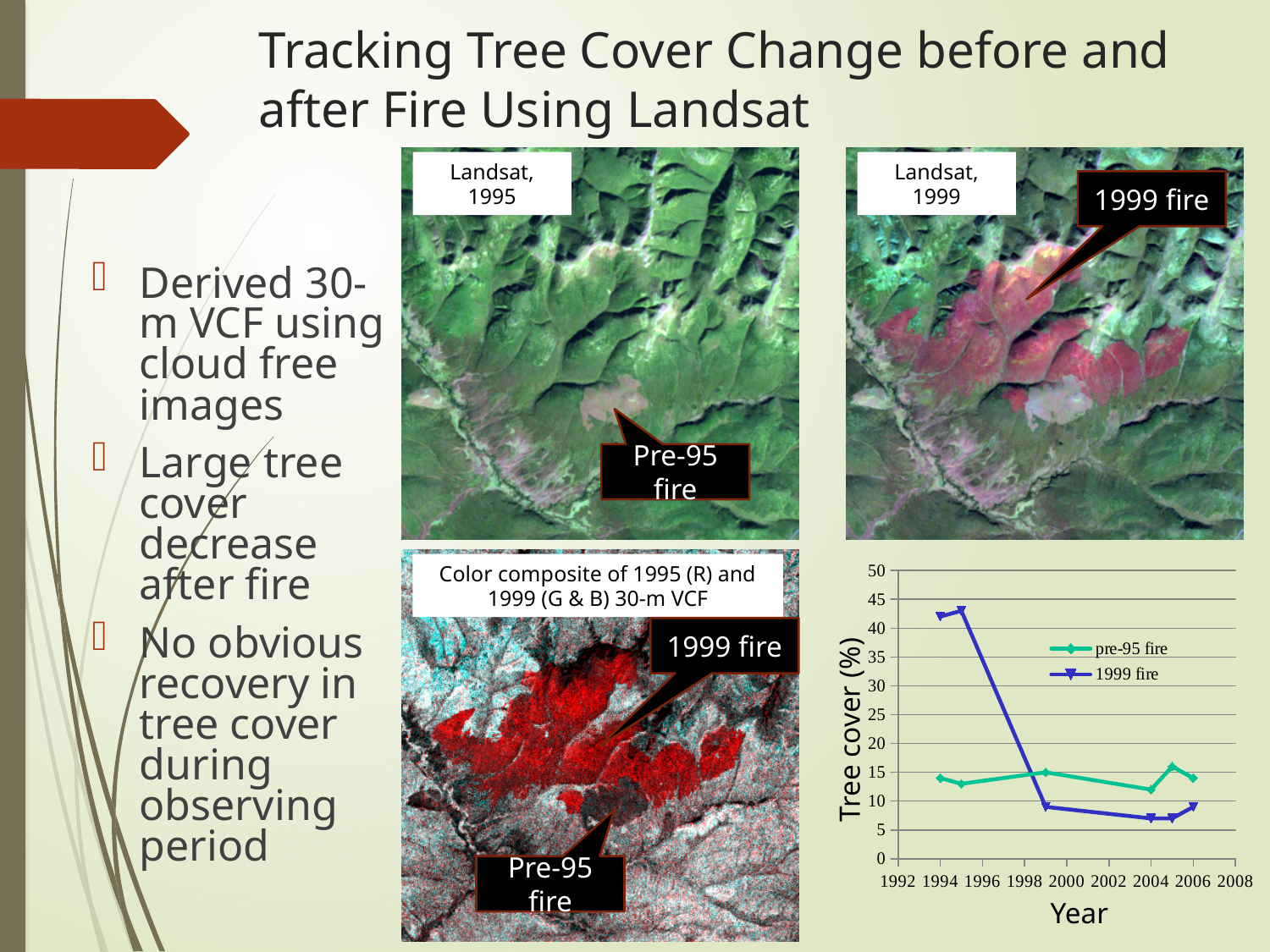
In the tree cover chart, is the value for the 1999 fire series in 2004 greater or less than 10? less How many series does the legend of the tree cover chart list? 2 In the tree cover chart, is the value for the pre-95 fire series in 1999 greater or less than 20? less In the tree cover chart, which series shows the larger drop in tree cover over the observing period? 1999 fire In the tree cover chart, does the 1999 fire series rise or fall between 1995 and 1999? fall In the tree cover chart, which series has the higher value in 1994, pre-95 fire or 1999 fire? 1999 fire What is the label on the vertical axis of the tree cover chart? Tree cover (%) What are the two series named in the legend of the tree cover chart? pre-95 fire and 1999 fire In the tree cover chart, is the value for the 1999 fire series in 1994 greater or less than 35? greater In the tree cover chart, which series has the higher value in 2004, pre-95 fire or 1999 fire? pre-95 fire What kind of chart is shown at the bottom right of the slide? line chart